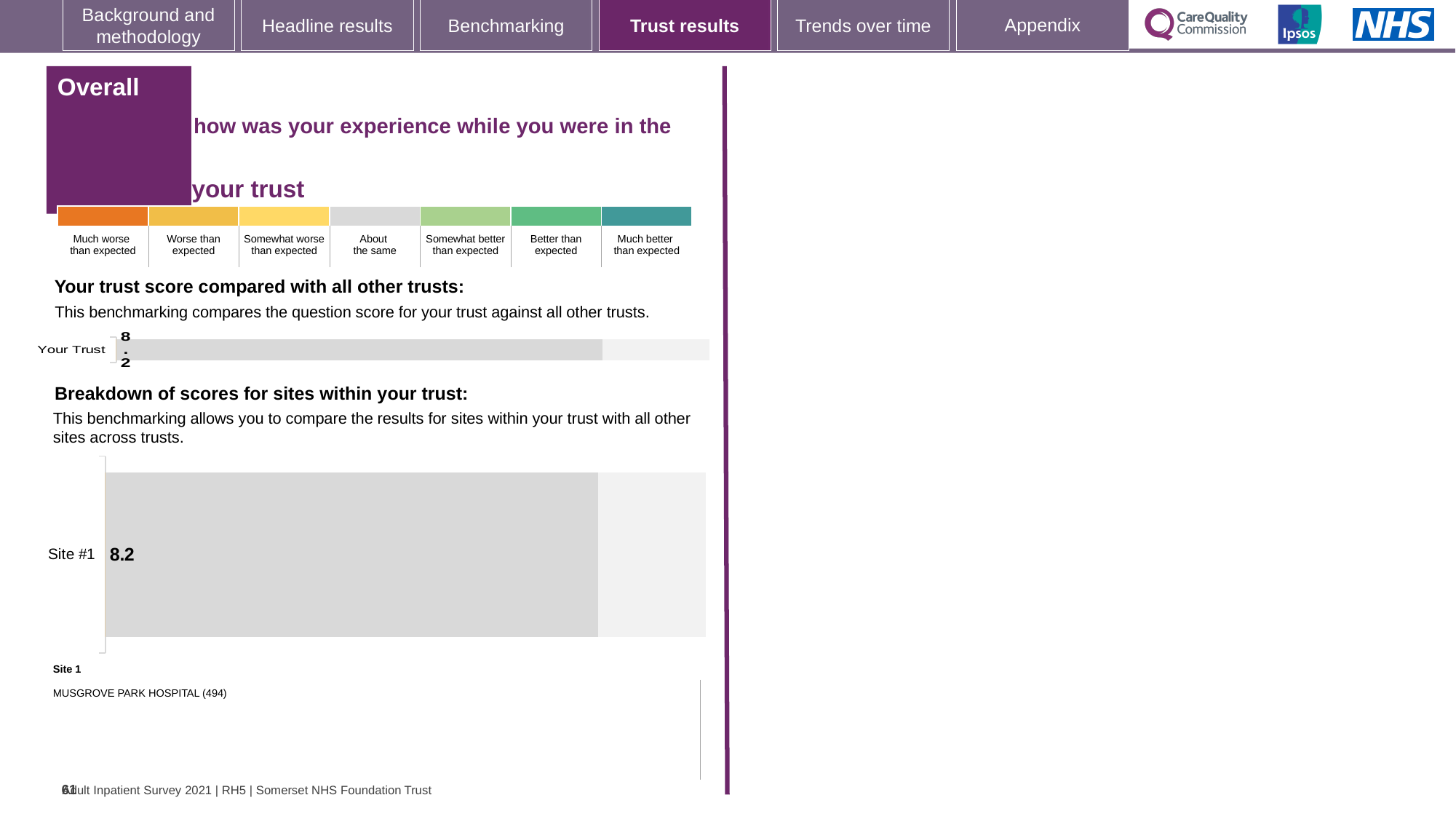
How many bars are plotted in the 'Your trust score compared with all other trusts' chart? 1 In the 'Your trust score compared with all other trusts' chart, what is the score for Your Trust? 8.2 What is the difference between the Your Trust score and the Site #1 score? 0 Is the score for Your Trust in the 'Your trust score compared with all other trusts' chart the same as the score for Site #1 in the 'Breakdown of scores for sites within your trust' chart? Yes, both are 8.2 What kind of chart is the 'Your trust score compared with all other trusts' chart? bar chart In the 'Breakdown of scores for sites within your trust' chart, what is the score for Site #1? 8.2 What kind of chart is the 'Breakdown of scores for sites within your trust' chart? bar chart What is the label of the only bar in the 'Your trust score compared with all other trusts' chart? Your Trust How many rating categories does the colour key above the charts list? 7 How many sites are plotted in the 'Breakdown of scores for sites within your trust' chart? 1